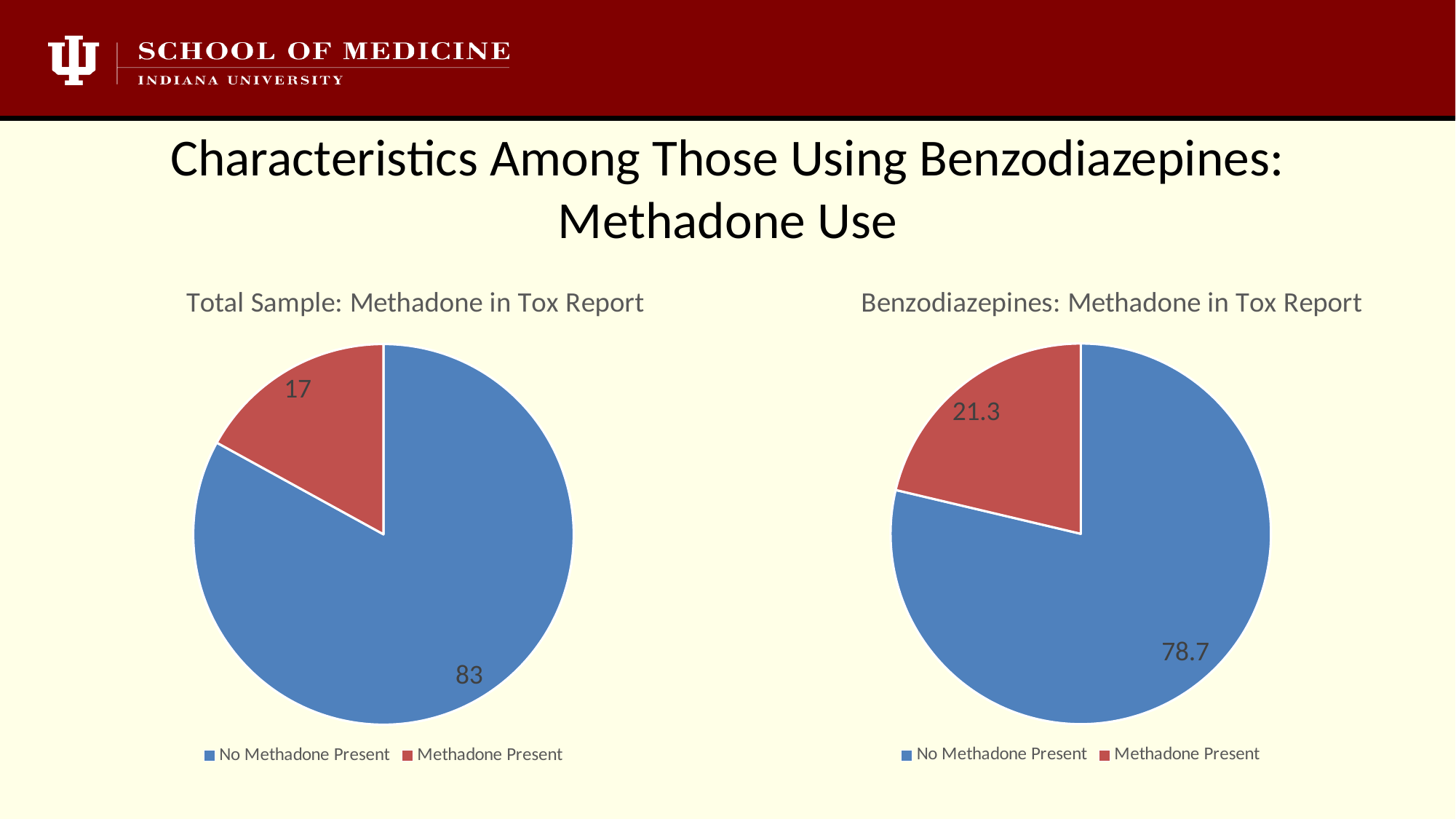
In the 'Total Sample: Methadone in Tox Report' chart, what is the value for No Methadone Present? 83 In the 'Total Sample: Methadone in Tox Report' chart, which category has the largest slice? No Methadone Present In the 'Benzodiazepines: Methadone in Tox Report' chart, what is the difference between the No Methadone Present and Methadone Present values? 57.4 In the 'Total Sample: Methadone in Tox Report' chart, what is the value for Methadone Present? 17 What type of chart is the 'Total Sample: Methadone in Tox Report' chart? Pie chart In the 'Benzodiazepines: Methadone in Tox Report' chart, which category has the smallest slice? Methadone Present Which chart shows a larger value for Methadone Present, the 'Total Sample' chart or the 'Benzodiazepines' chart? Benzodiazepines In the 'Benzodiazepines: Methadone in Tox Report' chart, what is the value for Methadone Present? 21.3 How many categories does the 'Benzodiazepines: Methadone in Tox Report' chart show? 2 In the 'Benzodiazepines: Methadone in Tox Report' chart, what is the value for No Methadone Present? 78.7 In the 'Total Sample: Methadone in Tox Report' chart, what is the difference between the No Methadone Present and Methadone Present values? 66 In the 'Benzodiazepines: Methadone in Tox Report' chart, what colour is the Methadone Present slice? Red